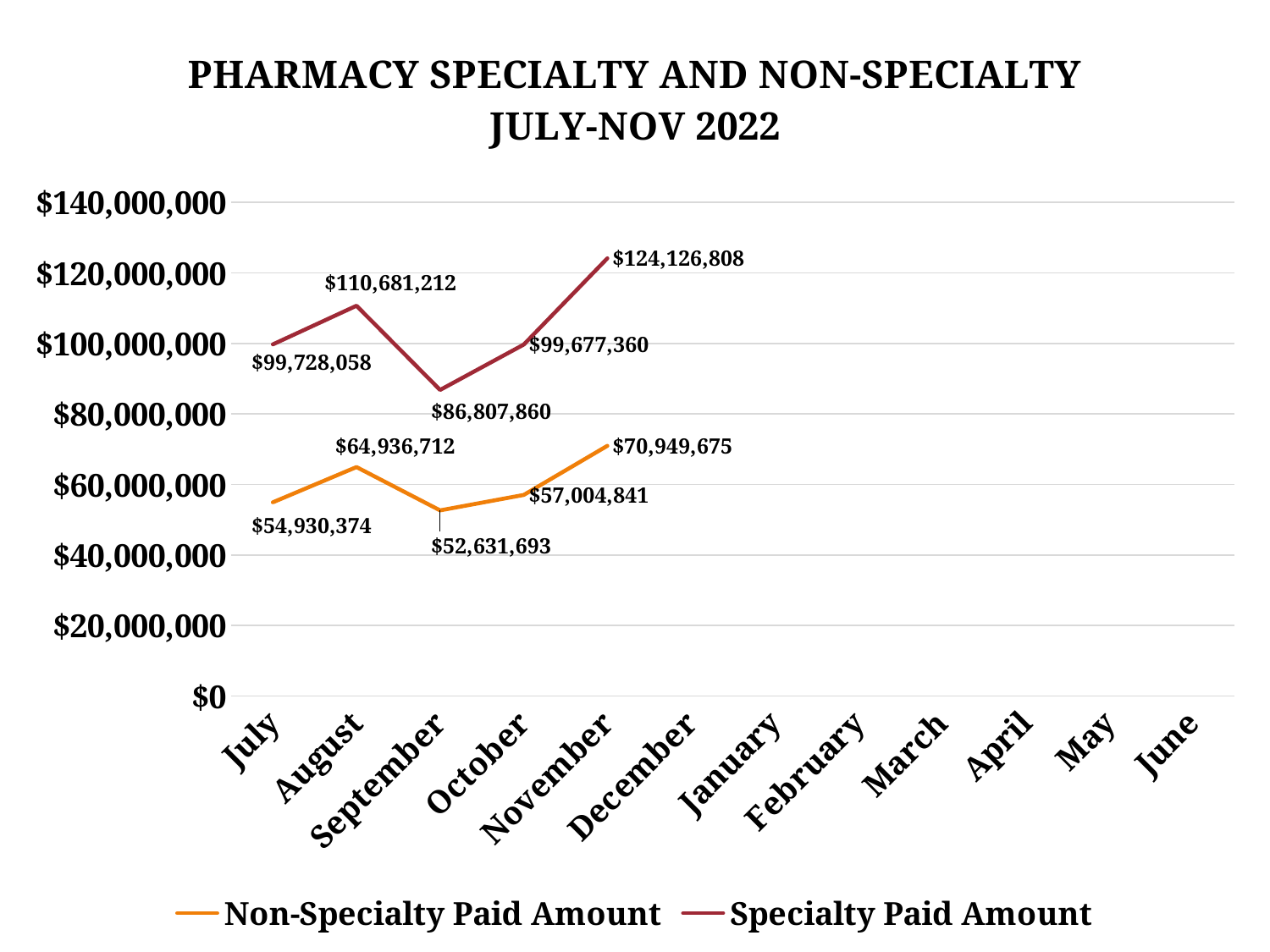
What is the Specialty Paid Amount for July? $99,728,058 Is the Specialty Paid Amount for September greater or less than $80,000,000? greater What is the Specialty Paid Amount for November? $124,126,808 What is the Non-Specialty Paid Amount for September? $52,631,693 Which month has the lowest Specialty Paid Amount? September How much higher is the Specialty Paid Amount in August than in July? $10,953,154 Which is larger, the Non-Specialty Paid Amount in August or in October? August What is the difference between the Specialty Paid Amount and the Non-Specialty Paid Amount in November? $53,177,133 What type of chart is shown on the slide? Line chart Which month has the highest Non-Specialty Paid Amount? November How many months have plotted data points on the chart? 5 How many series does the legend list? 2